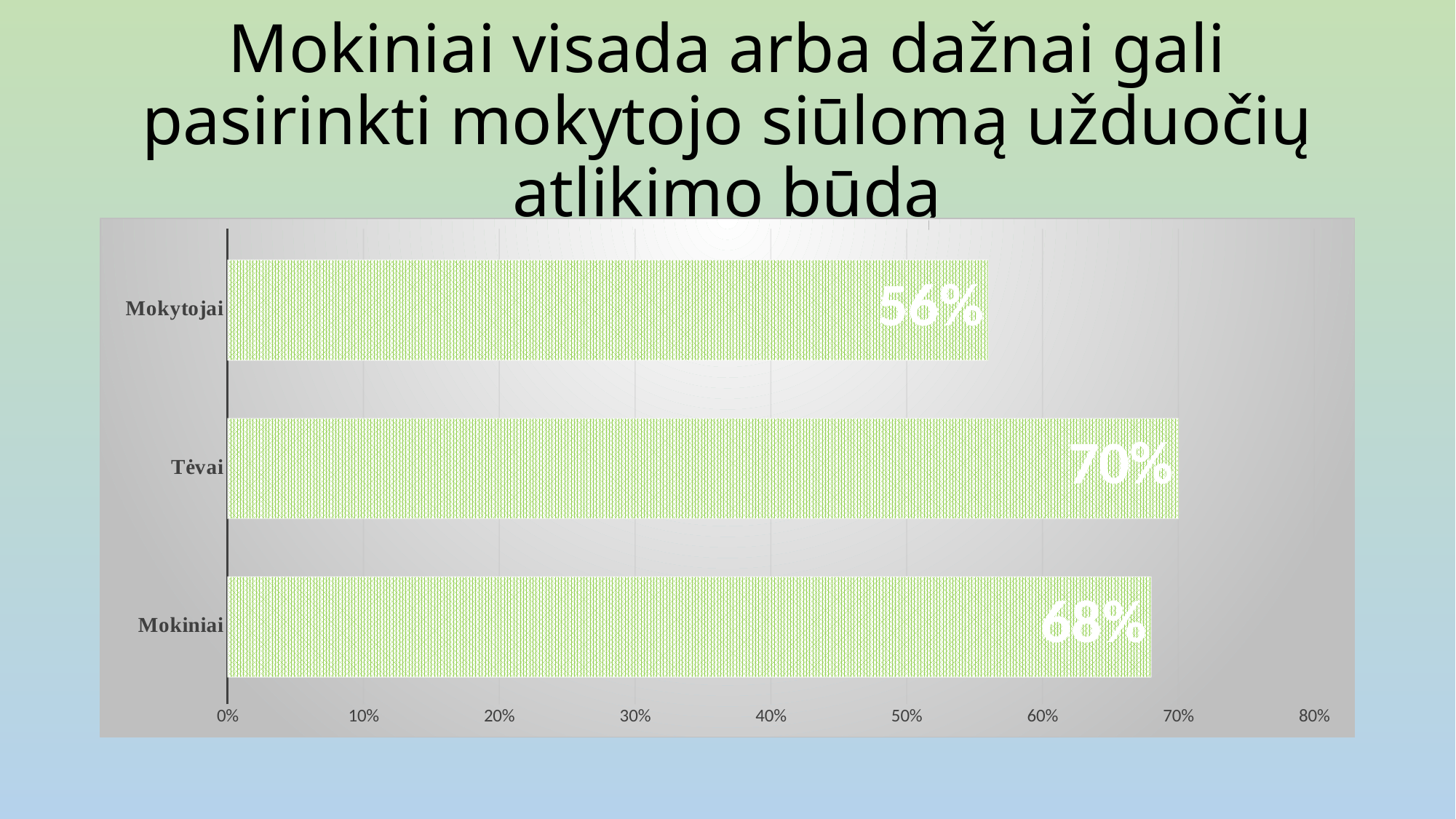
What is the value for Mokytojai? 56% Which category has the lowest value? Mokytojai How many categories are shown in the chart? 3 Which is larger, the value for Mokiniai or the value for Mokytojai? Mokiniai What is the difference between the values for Tėvai and Mokytojai? 14% Which category has the highest value? Tėvai What is the value for Mokiniai? 68% Is the value for Mokytojai greater or less than 60%? less What kind of chart is shown on the slide? bar chart What is the value for Tėvai? 70% What is the difference between the values for Mokiniai and Mokytojai? 12% What is the highest value shown on the x axis? 80%